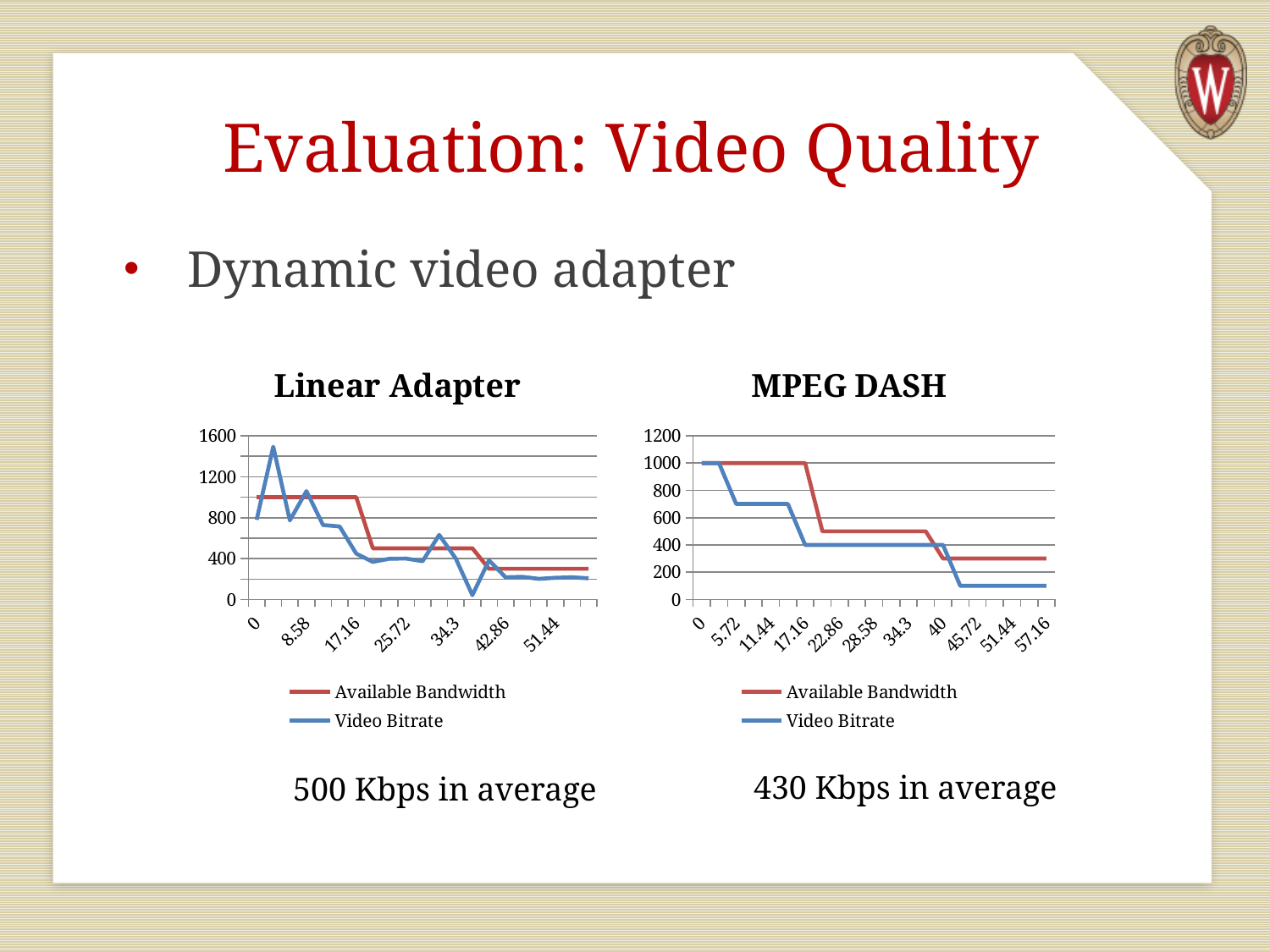
In the MPEG DASH chart, is the Available Bandwidth value at x = 57.16 greater or less than 400? less What are the two series named in the legend of the Linear Adapter chart? Available Bandwidth and Video Bitrate In the MPEG DASH chart, which series is higher at x = 11.44, Available Bandwidth or Video Bitrate? Available Bandwidth In the MPEG DASH chart, what is the Available Bandwidth value at x = 0? 1000 In the MPEG DASH chart, is the Video Bitrate value at x = 57.16 greater or less than 200? less In the MPEG DASH chart, do the Available Bandwidth values rise or fall along the x axis? fall In the Linear Adapter chart, is the Available Bandwidth value at x = 0 greater or less than 800? greater How many series does the legend of the MPEG DASH chart list? 2 What is the title of the chart on the right side of the slide? MPEG DASH What kind of chart is the Linear Adapter chart? line chart